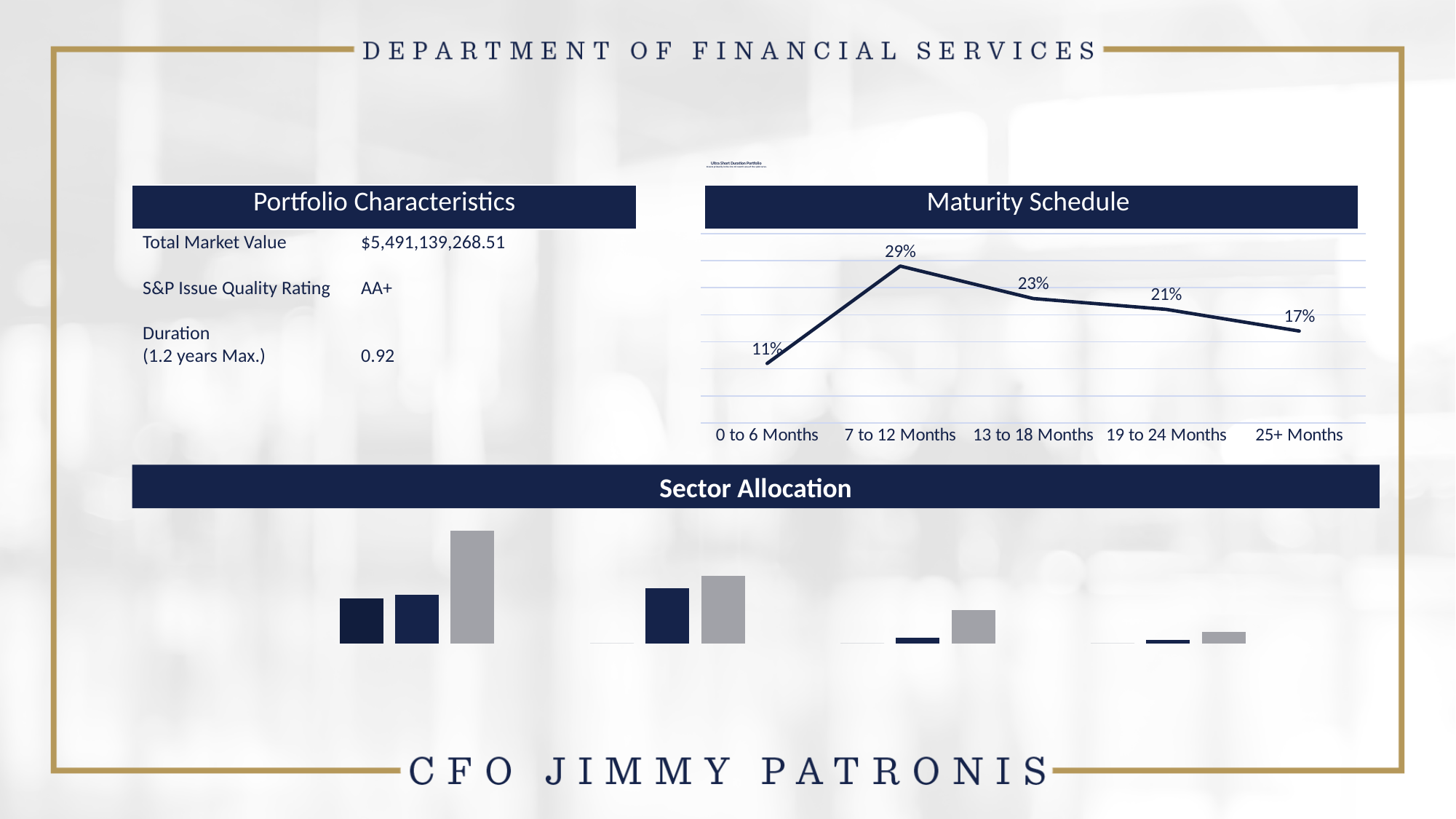
On the Maturity Schedule chart, which is larger: the value for 13 to 18 Months or the value for 25+ Months? 13 to 18 Months On the Maturity Schedule chart, what is the value for 25+ Months? 17% On the Maturity Schedule chart, what is the value for 19 to 24 Months? 21% On the Maturity Schedule chart, do the values rise or fall from 7 to 12 Months through 25+ Months? Fall What kind of chart is the Maturity Schedule chart? Line chart How many maturity buckets are plotted on the Maturity Schedule chart? 5 What kind of chart is shown under the Sector Allocation heading? Bar chart On the Maturity Schedule chart, what is the difference between the values for 7 to 12 Months and 13 to 18 Months? 6% On the Maturity Schedule chart, which maturity bucket has the highest value? 7 to 12 Months On the Maturity Schedule chart, what is the value for 7 to 12 Months? 29% On the Maturity Schedule chart, which maturity bucket has the lowest value? 0 to 6 Months On the Maturity Schedule chart, what is the value for 0 to 6 Months? 11%